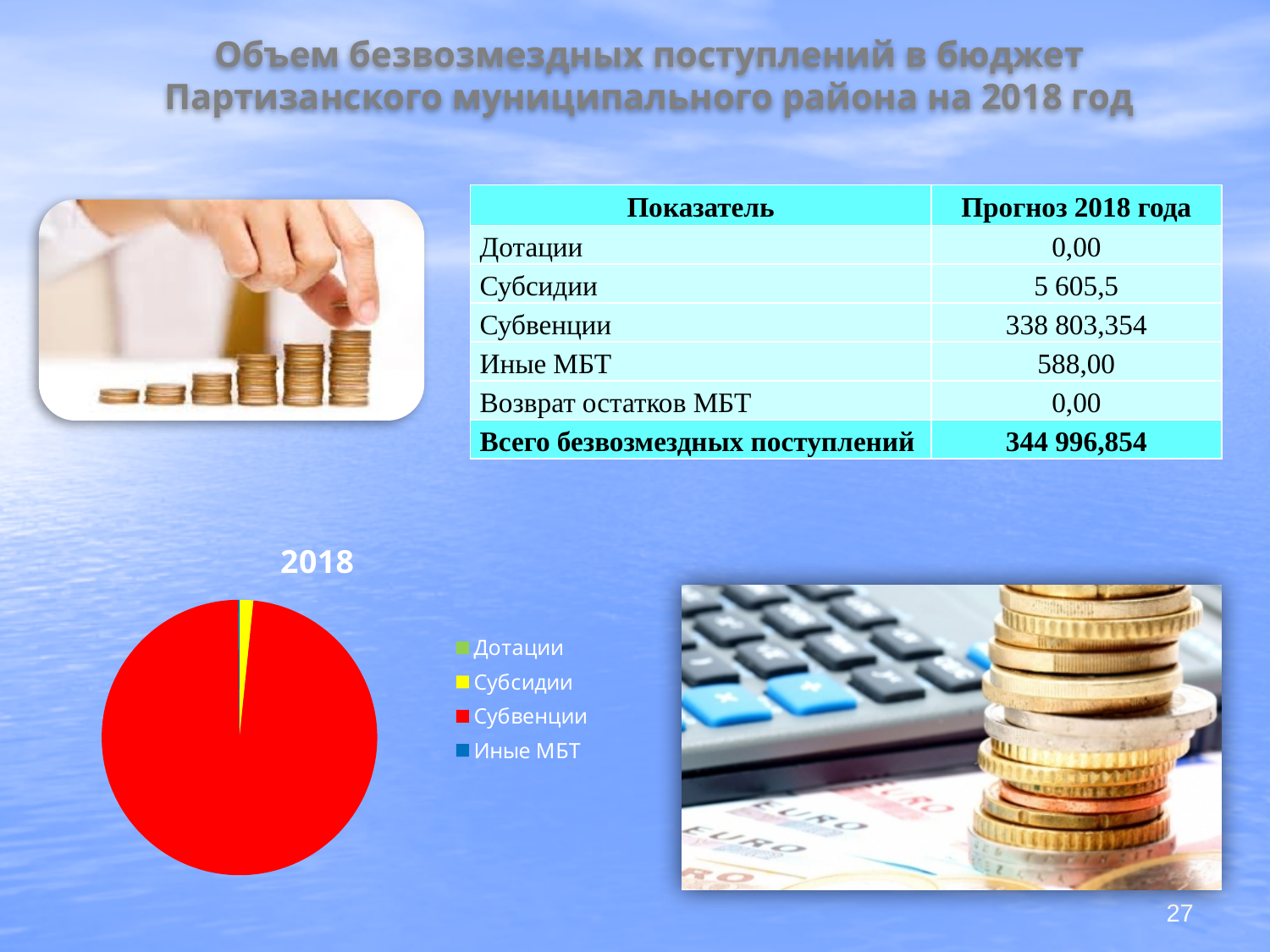
What kind of chart is shown at the bottom left of the slide? pie chart In the pie chart, which slice is larger: Субвенции or Субсидии? Субвенции Does the Субвенции slice take up more or less than half of the pie chart? more Which category takes up the largest slice of the pie chart? Субвенции What is the title of the pie chart? 2018 What colour represents Субвенции in the pie chart? red How many entries does the legend of the pie chart list? 4